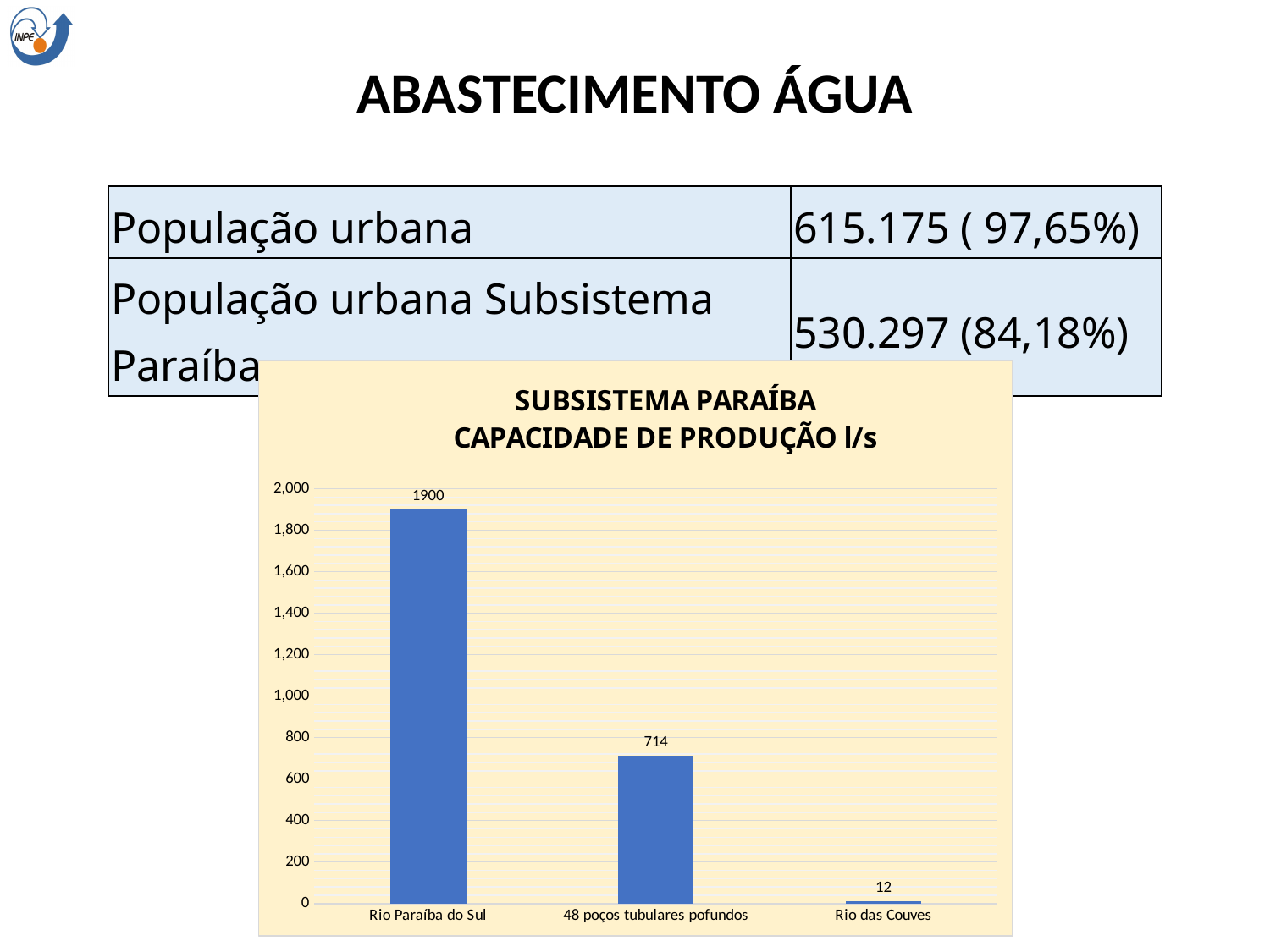
Which category has the lowest production capacity? Rio das Couves What is the difference between the values for Rio Paraíba do Sul and 48 poços tubulares pofundos? 1186 Which category has the highest production capacity? Rio Paraíba do Sul What is the production capacity value for 48 poços tubulares pofundos? 714 What is the production capacity value for Rio das Couves? 12 Is the value for 48 poços tubulares pofundos greater or less than 800? less What is the difference between the values for 48 poços tubulares pofundos and Rio das Couves? 702 How many categories are shown on the x axis of the chart? 3 What is the title of the chart? SUBSISTEMA PARAÍBA CAPACIDADE DE PRODUÇÃO l/s Which is larger, the value for 48 poços tubulares pofundos or the value for Rio das Couves? 48 poços tubulares pofundos What is the production capacity value for Rio Paraíba do Sul? 1900 What kind of chart is shown on the slide? bar chart